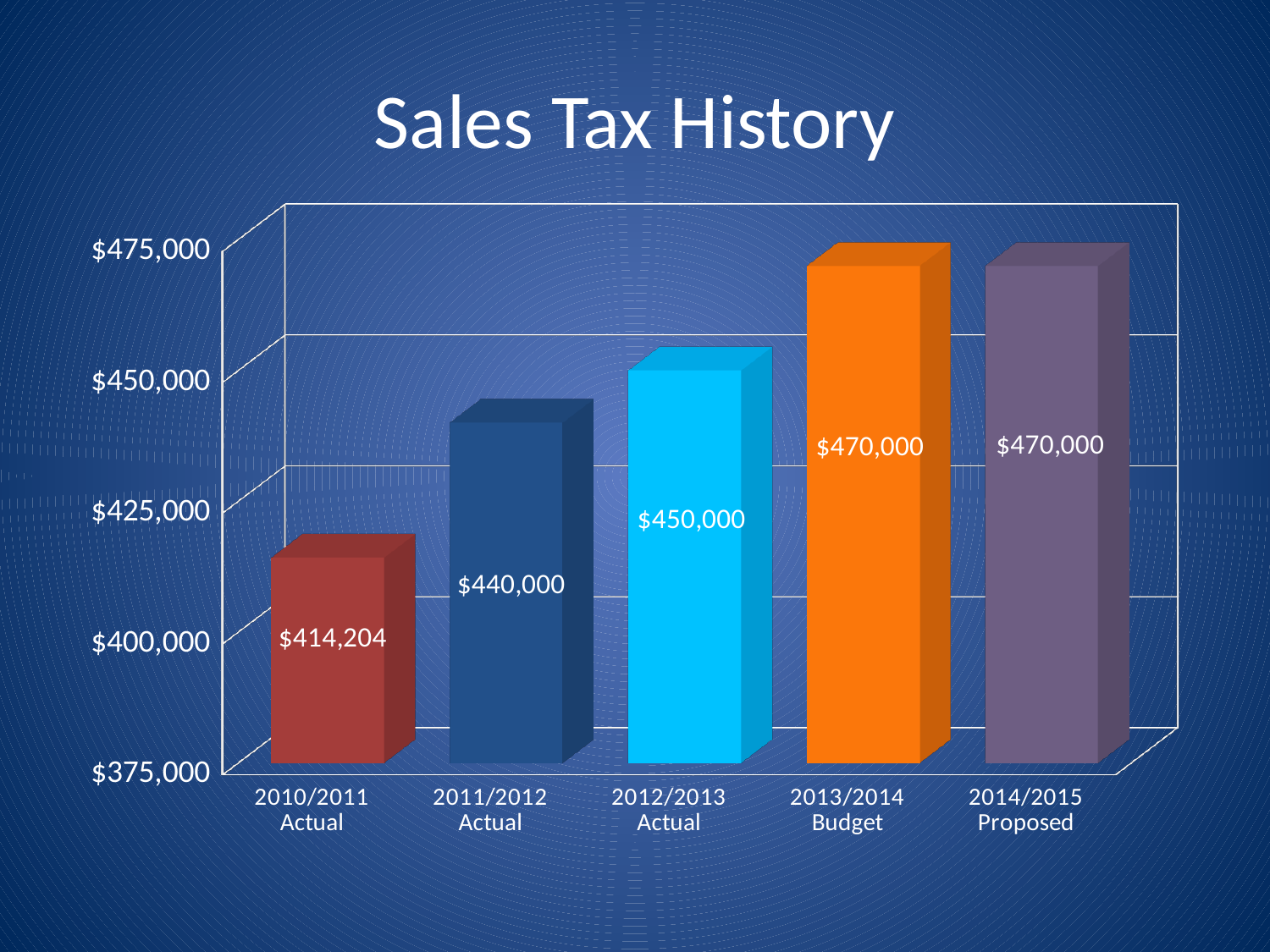
Which category has the lowest sales tax value? 2010/2011 Actual What is the sales tax value for 2014/2015 Proposed? $470,000 What is the sales tax value for 2010/2011 Actual? $414,204 What is the title of the chart? Sales Tax History What kind of chart is shown on the slide? bar chart What is the difference between the 2011/2012 Actual and 2010/2011 Actual values? $25,796 How many categories are shown on the x axis? 5 Which is larger, the value for 2011/2012 Actual or 2012/2013 Actual? 2012/2013 Actual What is the sales tax value for 2012/2013 Actual? $450,000 Is the value for 2010/2011 Actual greater or less than $425,000? less What is the sales tax value for 2011/2012 Actual? $440,000 What is the difference between the 2013/2014 Budget and the 2012/2013 Actual values? $20,000